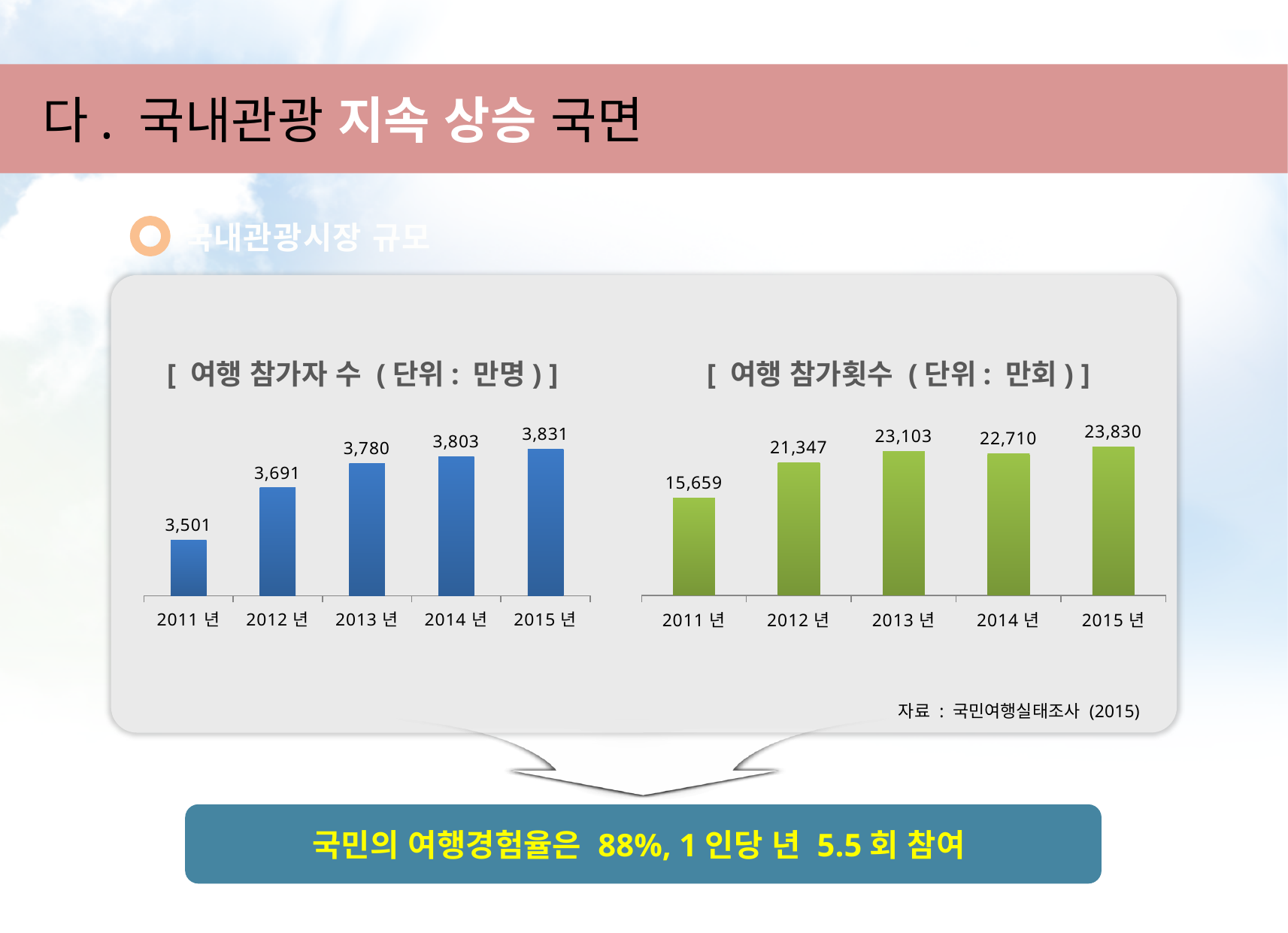
In the left chart (여행 참가자 수), do the values rise or fall from 2011년 to 2015년? Rise In the left chart (여행 참가자 수), what is the value for 2011년? 3,501 In the left chart (여행 참가자 수), what is the difference between the 2015년 and 2011년 values? 330 In the left chart (여행 참가자 수), which year has the highest value? 2015년 In the right chart (여행 참가횟수), which is larger, the value for 2013년 or 2014년? 2013년 How many years are shown on the x axis of the left chart (여행 참가자 수)? 5 In the right chart (여행 참가횟수), what is the value for 2012년? 21,347 In the left chart (여행 참가자 수), what is the value for 2014년? 3,803 In the right chart (여행 참가횟수), what is the difference between the 2013년 and 2014년 values? 393 In the right chart (여행 참가횟수), what is the value for 2015년? 23,830 In the right chart (여행 참가횟수), which year has the lowest value? 2011년 What kind of chart is the right chart (여행 참가횟수)? Bar chart